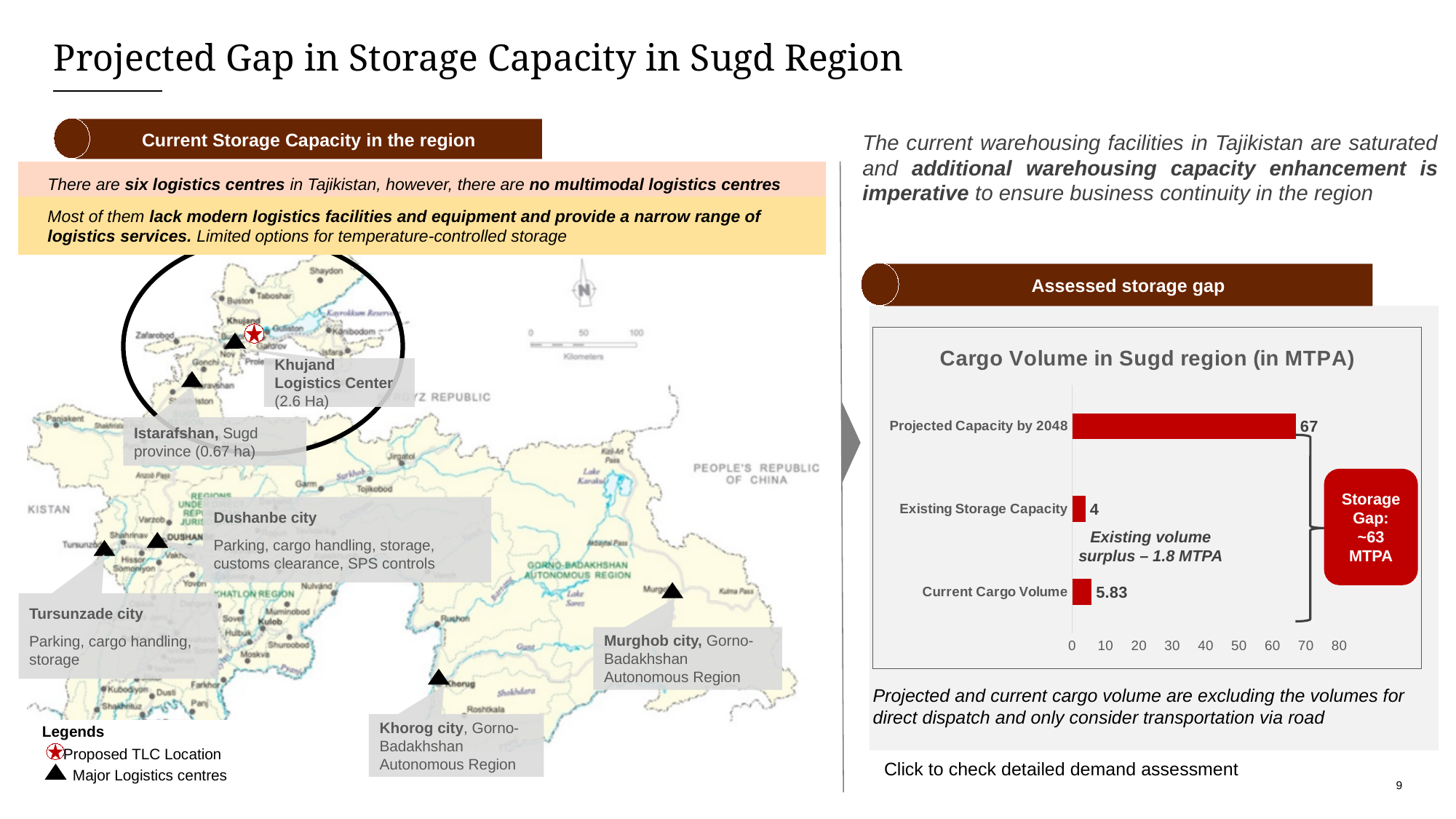
What is the difference between Current Cargo Volume and Existing Storage Capacity in the Cargo Volume in Sugd region chart? 1.83 Is the value for Projected Capacity by 2048 greater or less than 60 in the Cargo Volume in Sugd region chart? greater What unit is stated in the title of the Cargo Volume in Sugd region chart? MTPA Which category has the highest value in the Cargo Volume in Sugd region chart? Projected Capacity by 2048 Which is larger in the Cargo Volume in Sugd region chart: Current Cargo Volume or Existing Storage Capacity? Current Cargo Volume How many categories are shown in the Cargo Volume in Sugd region chart? 3 What kind of chart is the Cargo Volume in Sugd region chart? Bar chart What is the value for Projected Capacity by 2048 in the Cargo Volume in Sugd region chart? 67 What is the difference between Projected Capacity by 2048 and Existing Storage Capacity in the Cargo Volume in Sugd region chart? 63 What is the value for Existing Storage Capacity in the Cargo Volume in Sugd region chart? 4 What is the value for Current Cargo Volume in the Cargo Volume in Sugd region chart? 5.83 Which category has the lowest value in the Cargo Volume in Sugd region chart? Existing Storage Capacity